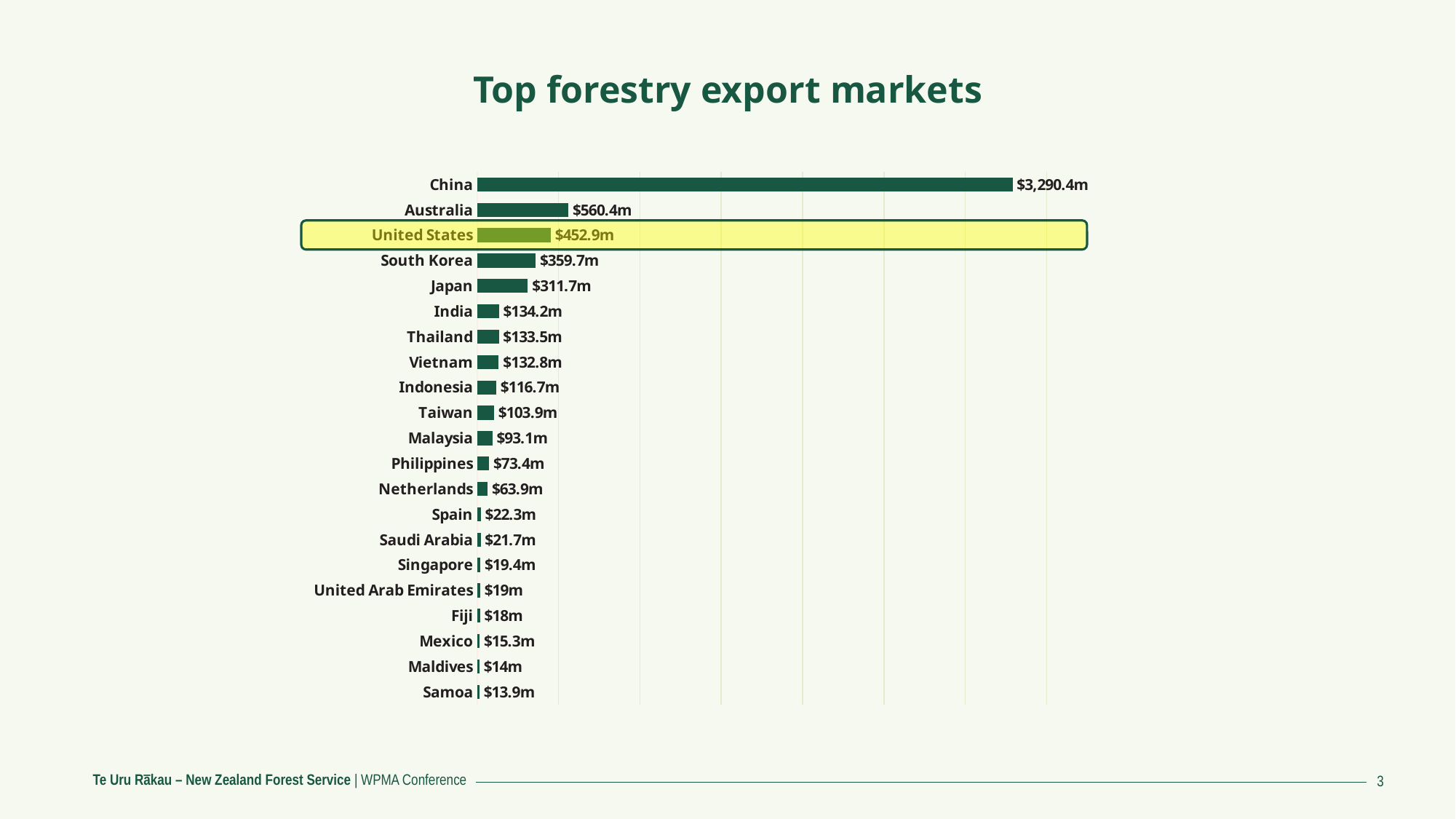
Which market has the highest value? China Which market's bar is highlighted with a yellow box? United States What is the value for Netherlands? $63.9m Which is larger, the value for Japan or the value for India? Japan How many markets are shown in the chart? 21 What is the title of the chart? Top forestry export markets What kind of chart is this? Bar chart What is the difference between the values for China and Australia? $2,730m What is the difference between the values for South Korea and Japan? $48m What is the value for China? $3,290.4m What is the value for the United States? $452.9m Which market has the lowest value? Samoa